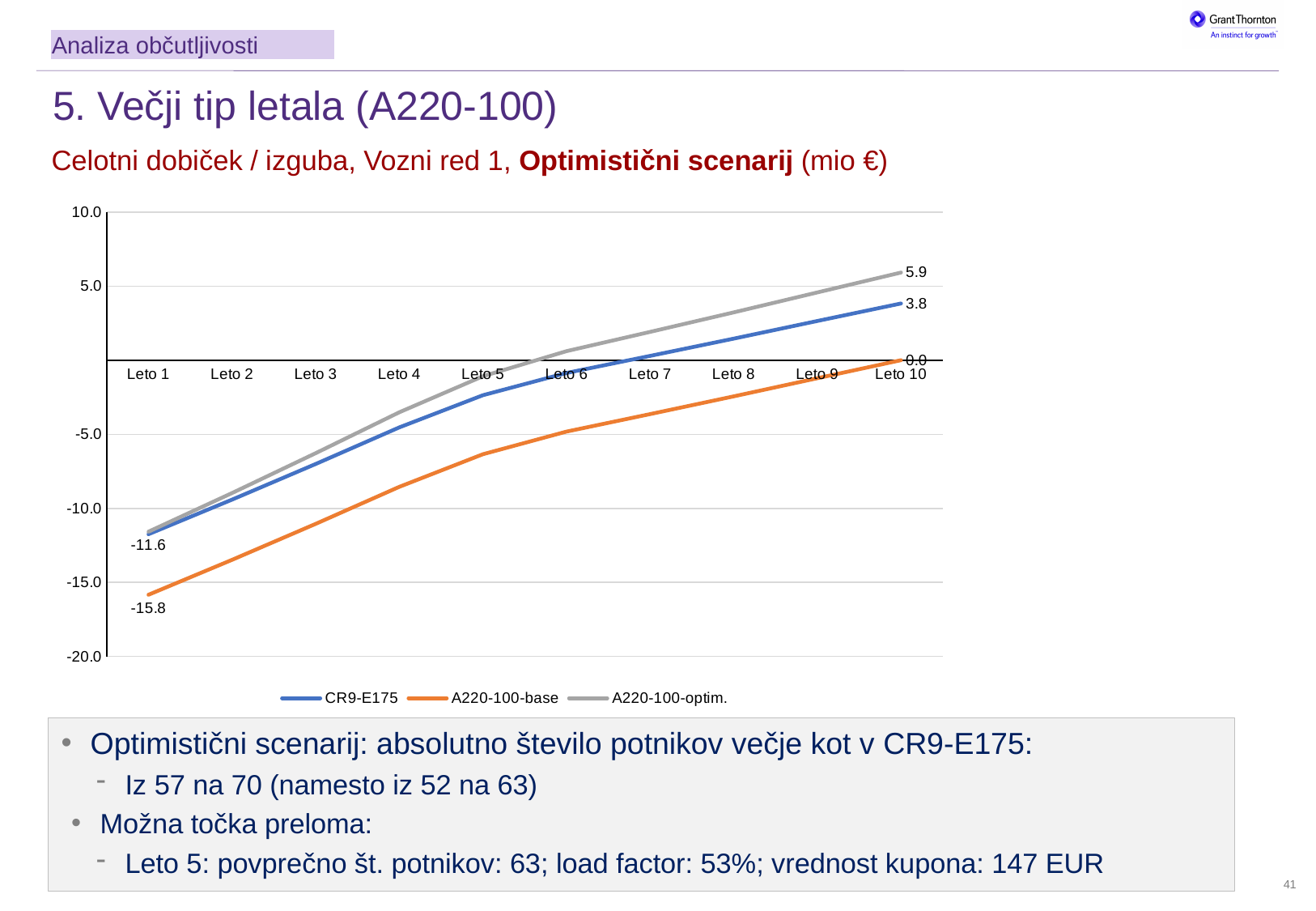
What is the value for A220-100-optim. in Leto 10? 5.9 In Leto 10, which is higher: CR9-E175 or A220-100-base? CR9-E175 Is the value for A220-100-base in Leto 5 greater or less than -5.0? less How many series does the legend list? 3 What is the value for A220-100-base in Leto 10? 0.0 Which series has the highest value in Leto 10? A220-100-optim. What type of chart is shown on the slide? line chart What is the value for CR9-E175 in Leto 10? 3.8 What is the value for A220-100-base in Leto 1? -15.8 Do the values for A220-100-base rise or fall from Leto 1 to Leto 10? rise How many years (categories) are shown on the x axis? 10 What is the difference between A220-100-optim. and CR9-E175 in Leto 10? 2.1